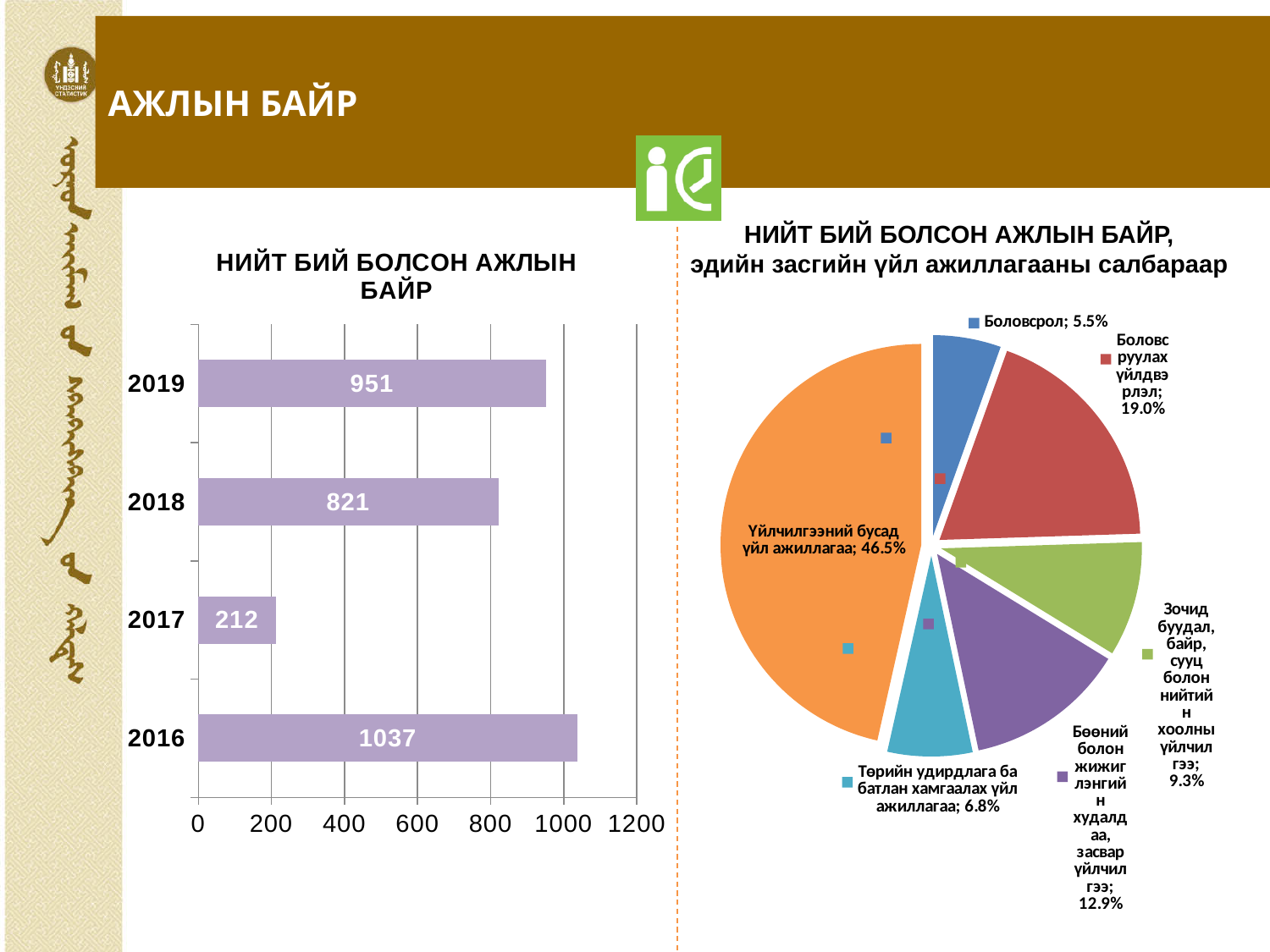
In the bar chart 'НИЙТ БИЙ БОЛСОН АЖЛЫН БАЙР', what is the value for 2019? 951 In the bar chart 'НИЙТ БИЙ БОЛСОН АЖЛЫН БАЙР', how many years are shown? 4 In the bar chart 'НИЙТ БИЙ БОЛСОН АЖЛЫН БАЙР', what is the value for 2017? 212 In the pie chart on the right, how many slices are there? 6 In the bar chart 'НИЙТ БИЙ БОЛСОН АЖЛЫН БАЙР', what is the difference between the values for 2019 and 2018? 130 What kind of chart is the left chart 'НИЙТ БИЙ БОЛСОН АЖЛЫН БАЙР'? Bar chart In the pie chart on the right, what share does 'Үйлчилгээний бусад үйл ажиллагаа' have? 46.5% In the bar chart 'НИЙТ БИЙ БОЛСОН АЖЛЫН БАЙР', which is larger, the value for 2016 or the value for 2019? 2016 In the bar chart 'НИЙТ БИЙ БОЛСОН АЖЛЫН БАЙР', which year has the highest value? 2016 In the pie chart on the right, which slice is the smallest? Боловсрол In the pie chart on the right, what share does 'Боловсруулах үйлдвэрлэл' have? 19.0% In the bar chart 'НИЙТ БИЙ БОЛСОН АЖЛЫН БАЙР', which year has the lowest value? 2017